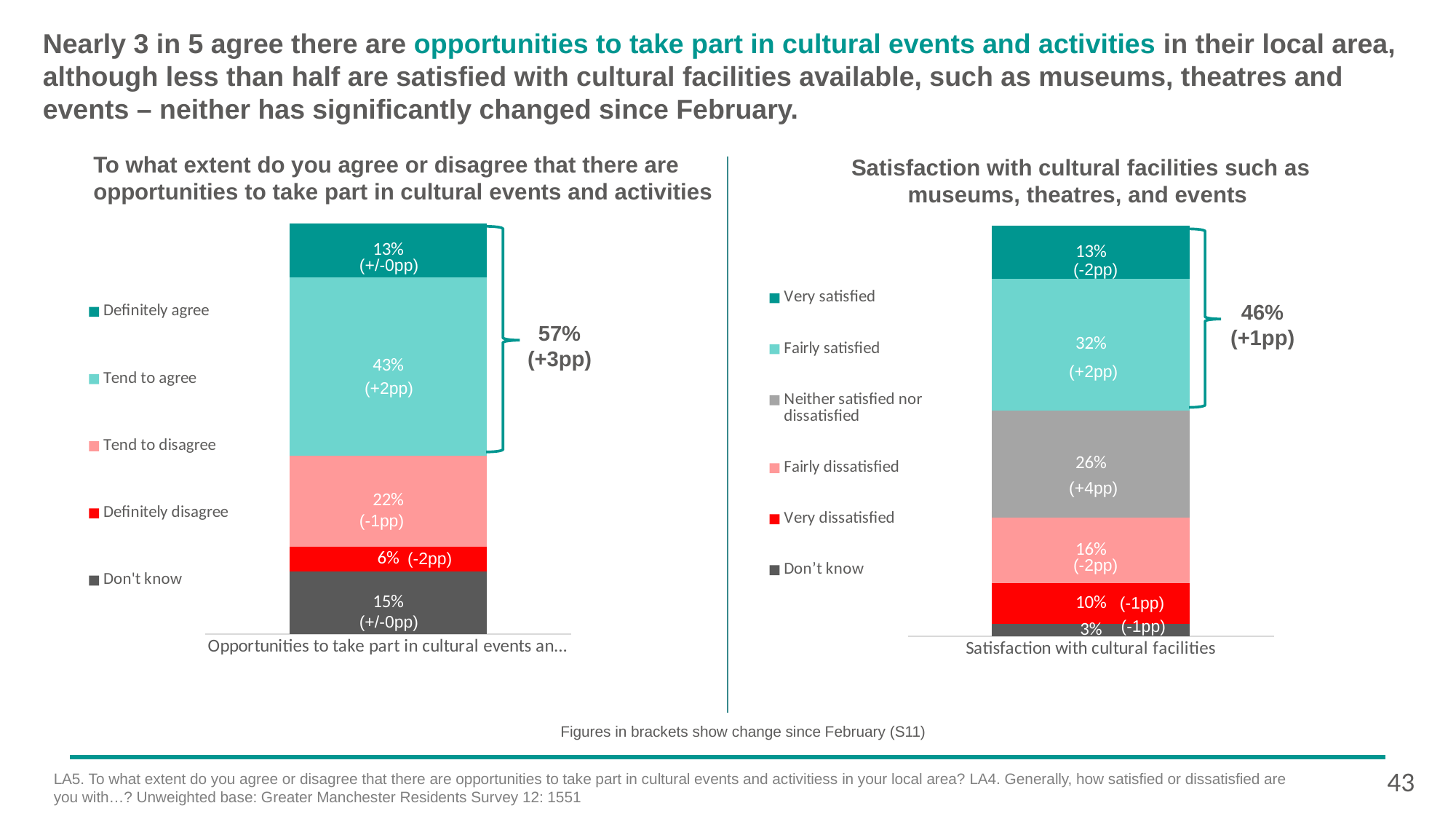
What type of chart is used in the left chart on opportunities to take part in cultural events and activities? Stacked bar chart In the right chart on satisfaction with cultural facilities, which response category has the smallest share? Don't know In the left chart on opportunities to take part in cultural events and activities, what percentage of respondents 'Tend to agree'? 43% In the left chart on opportunities to take part in cultural events and activities, what percentage of respondents 'Definitely disagree'? 6% In the left chart on opportunities to take part in cultural events and activities, which response category has the largest share? Tend to agree In the right chart on satisfaction with cultural facilities, what percentage of respondents are 'Neither satisfied nor dissatisfied'? 26% How many response categories does the legend of the right chart on satisfaction with cultural facilities list? 6 In the right chart on satisfaction with cultural facilities, which is larger: 'Fairly satisfied' or 'Fairly dissatisfied'? Fairly satisfied In the left chart on opportunities to take part in cultural events and activities, what is the difference between the 'Tend to agree' and 'Tend to disagree' percentages? 21 percentage points In the right chart on satisfaction with cultural facilities, what is the combined percentage of 'Very satisfied' and 'Fairly satisfied' shown by the bracket? 46% In the left chart on opportunities to take part in cultural events and activities, what change since February is shown for 'Tend to agree'? +2pp In the right chart on satisfaction with cultural facilities, what percentage of respondents are 'Very dissatisfied'? 10%